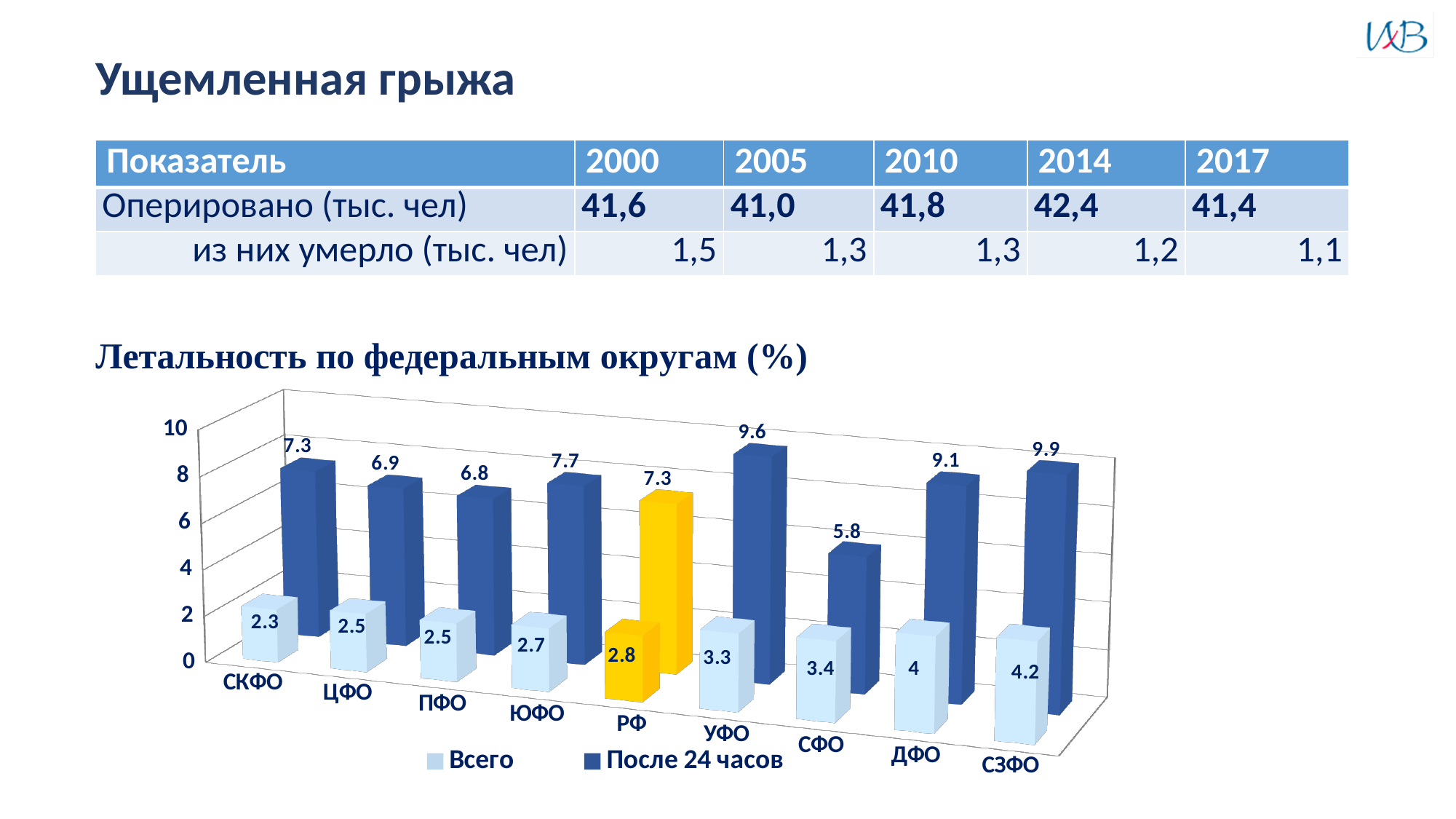
What is the value of 'После 24 часов' for СФО? 5.8 What is the value of 'Всего' for РФ? 2.8 Which is larger: the 'После 24 часов' value for ДФО or for ЮФО? ДФО What is the value of 'После 24 часов' for УФО? 9.6 What type of chart is shown on the slide? Bar chart How many series does the chart legend list? 2 How many federal districts (categories) are shown on the x axis of the chart? 9 What is the difference between the 'После 24 часов' values for СЗФО and СФО? 4.1 What is the title of the chart? Летальность по федеральным округам (%) Which category has the lowest 'Всего' value? СКФО Which category has the highest 'После 24 часов' value? СЗФО Does the 'Всего' value generally rise or fall moving from СКФО to СЗФО along the x axis? Rise